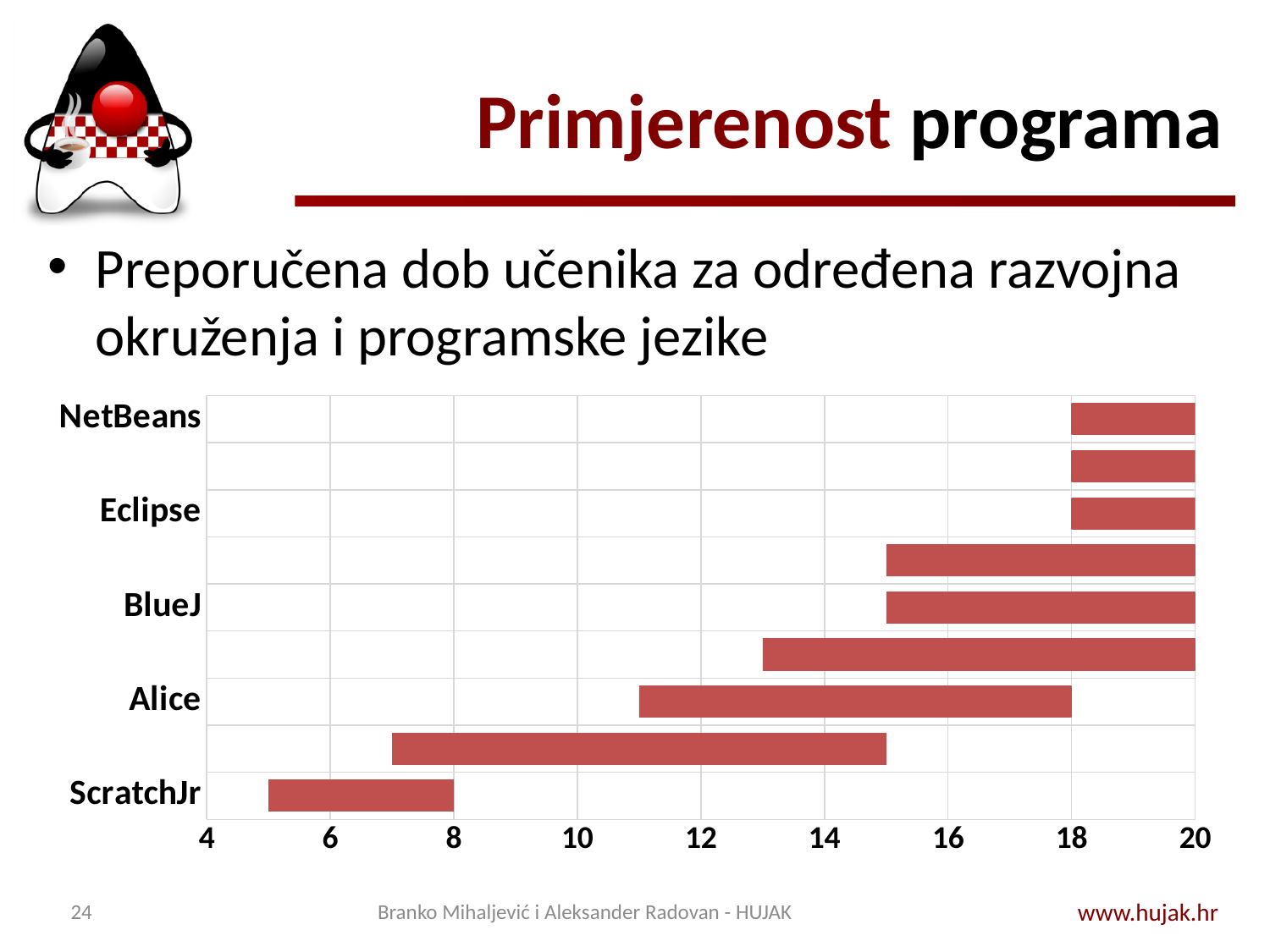
How many bars are plotted in the chart? 9 Is the starting age of the BlueJ bar greater or less than 14? greater Is the starting age of the Alice bar greater or less than 10? greater At what age does the Alice bar end on the x axis? 18 Which labeled category's bar starts at the lowest age? ScratchJr What kind of chart is shown on the slide? bar chart What age range does the Eclipse bar cover? 18 to 20 How many category labels are readable on the vertical axis of the chart? 5 What is the highest value shown on the x axis of the chart? 20 At what age does the ScratchJr bar end on the x axis? 8 At what age does the NetBeans bar start on the x axis? 18 Which bar starts at a younger age, ScratchJr or Alice? ScratchJr